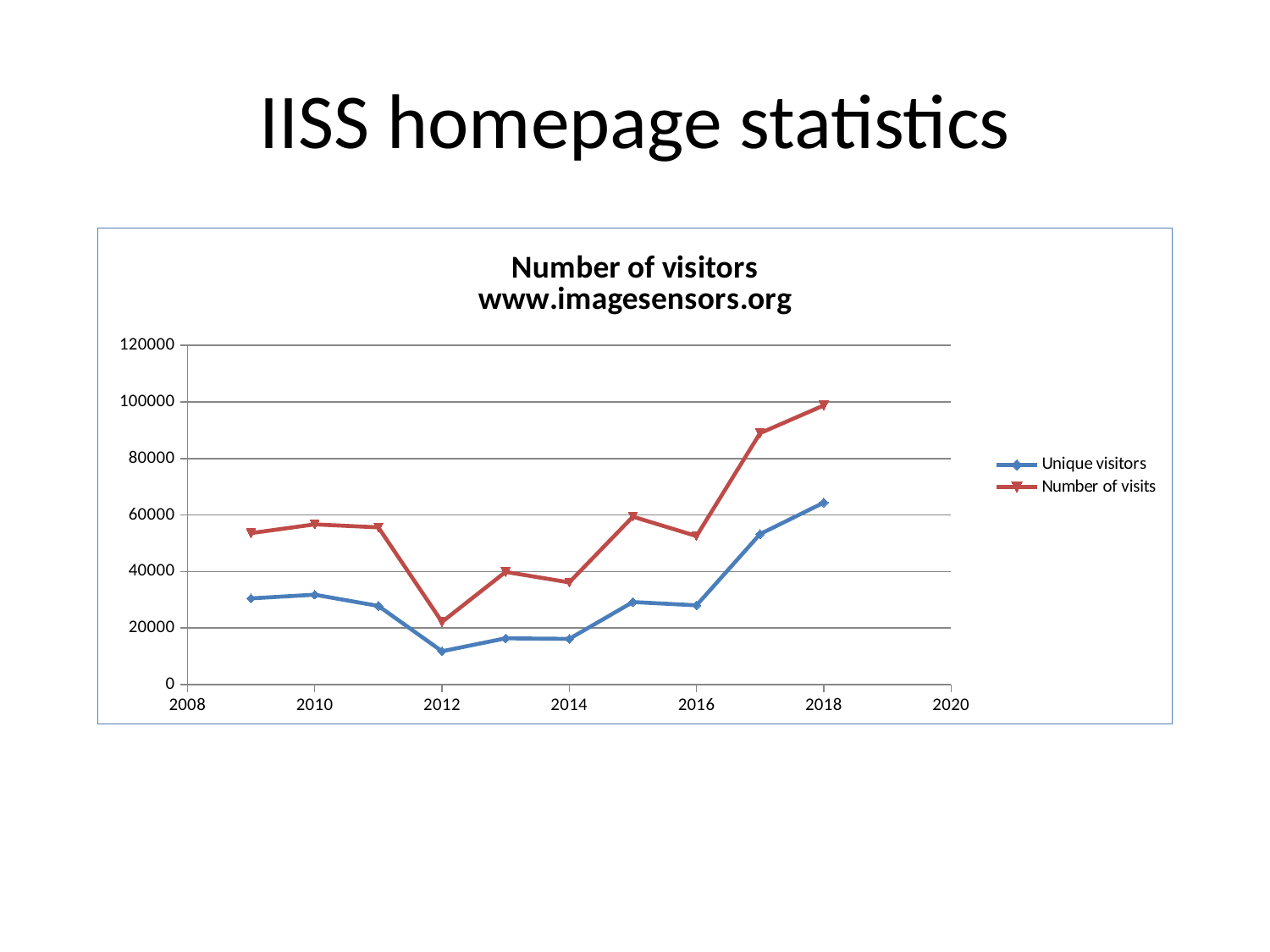
Do the Number of visits values rise or fall from 2016 to 2018? rise Is the Unique visitors value for 2012 greater or less than 20000? less Is the Number of visits value for 2017 greater or less than 80000? greater Which is larger in 2018, Unique visitors or Number of visits? Number of visits How many data points are plotted for the Number of visits series? 10 Is the Number of visits value for 2018 greater or less than 80000? greater In which year is the Number of visits highest? 2018 Which series is drawn in red? Number of visits What is the title of the chart? Number of visitors www.imagesensors.org What kind of chart is shown on the slide? line chart How many series does the legend list? 2 In which year is the Unique visitors value lowest? 2012